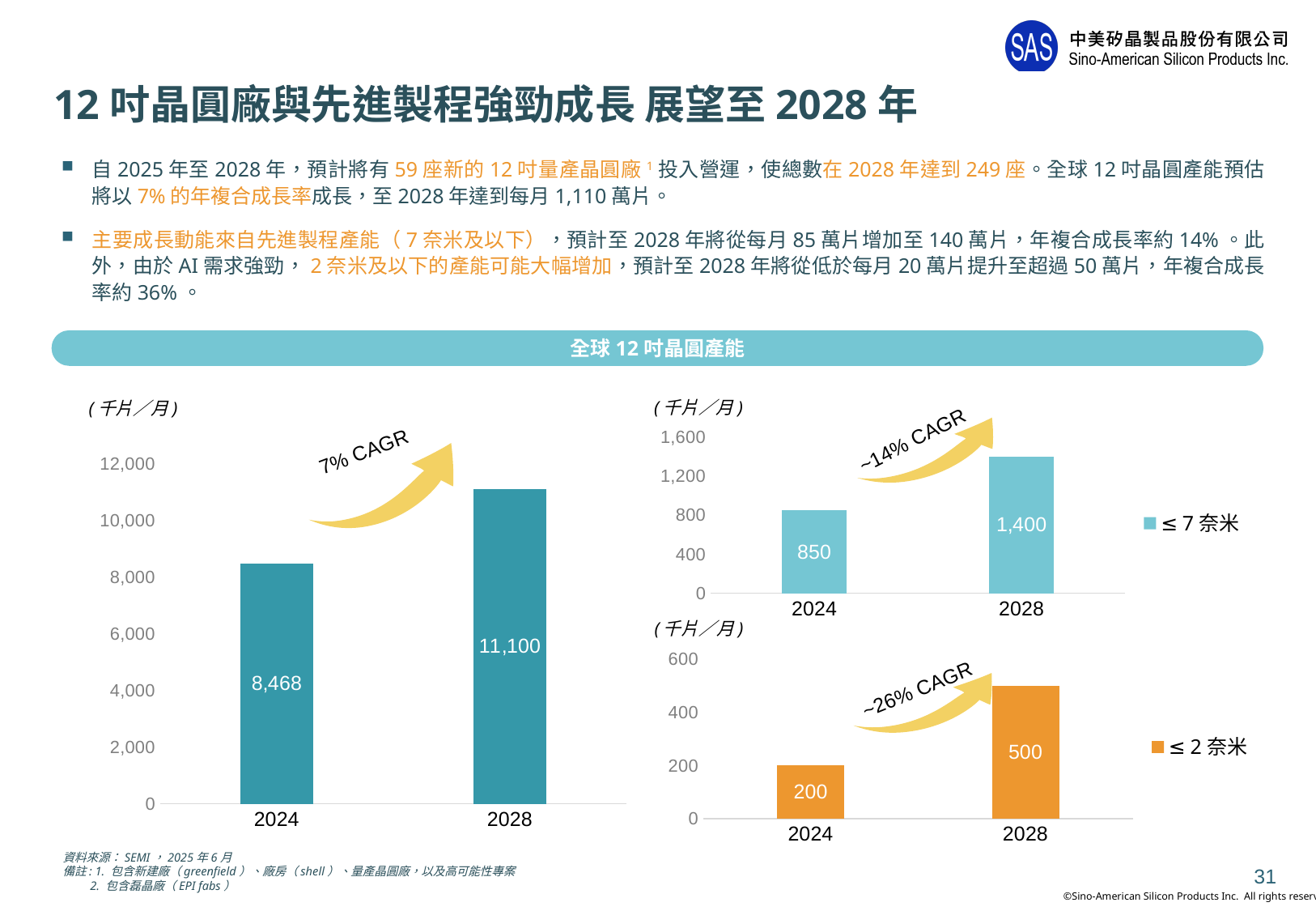
In the bottom-right chart (≤ 2 奈米), which year has the lower value? 2024 In the top-right chart (≤ 7 奈米), what is the value for 2028? 1,400 In the left chart of global 12-inch wafer capacity, what is the value for 2028? 11,100 What kind of chart is the left chart of global 12-inch wafer capacity? Bar chart In the left chart of global 12-inch wafer capacity, what is the difference between the 2028 and 2024 values? 2,632 In the bottom-right chart (≤ 2 奈米), what is the difference between the 2028 and 2024 values? 300 In the bottom-right chart (≤ 2 奈米), what is the value for 2028? 500 In the left chart of global 12-inch wafer capacity, what is the value for 2024? 8,468 In the top-right chart (≤ 7 奈米), what is the value for 2024? 850 What CAGR is labelled on the bottom-right chart (≤ 2 奈米)? ~26% CAGR In the left chart of global 12-inch wafer capacity, do the values rise or fall from 2024 to 2028? Rise In the top-right chart (≤ 7 奈米), by how much does the value increase from 2024 to 2028? 550